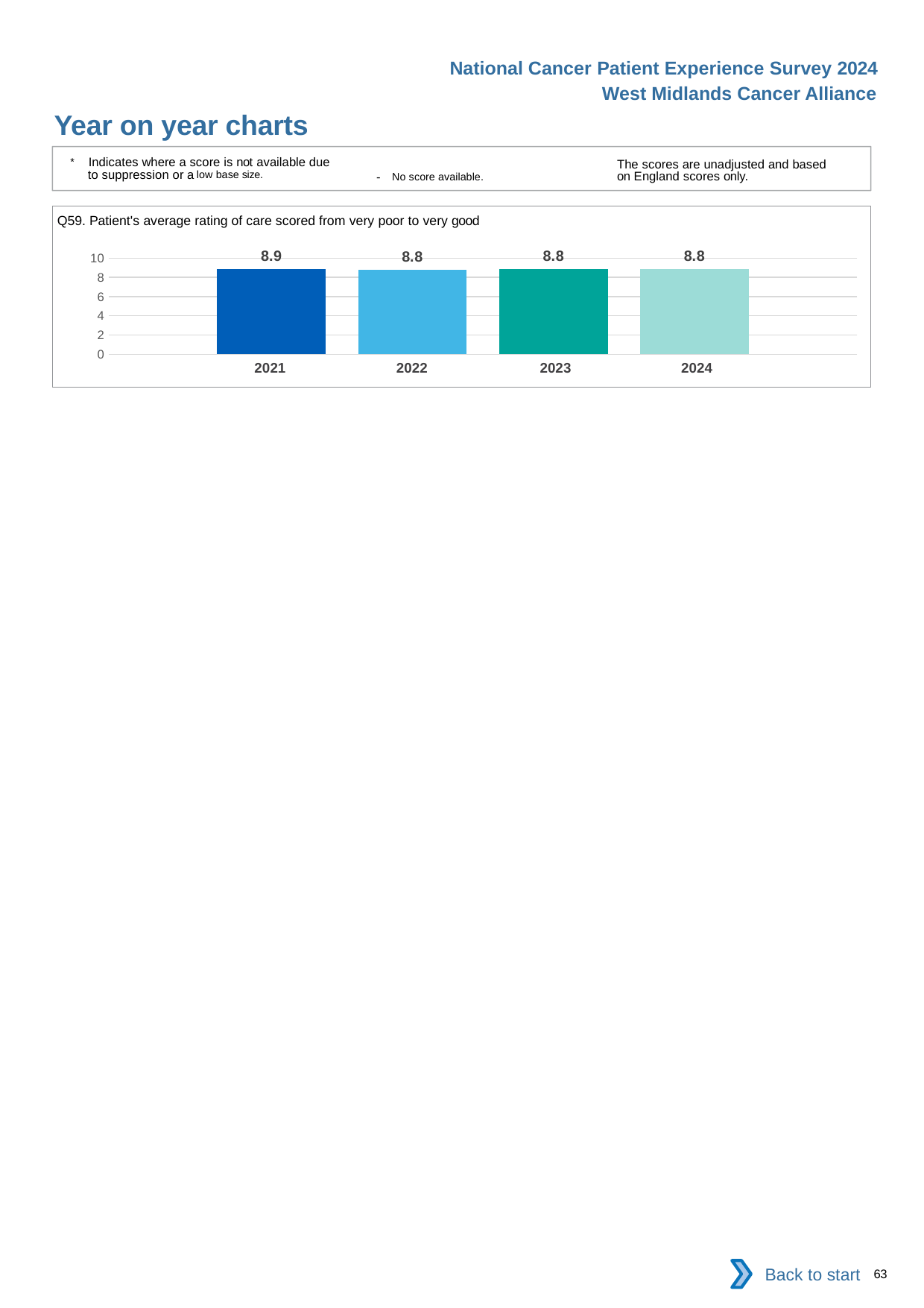
How many years are shown in the Q59 chart? 4 Do the values in the Q59 chart rise or fall from 2021 to 2022? Fall What is the value for 2022 in the Q59 chart? 8.8 What is the difference between the 2021 and 2023 values in the Q59 chart? 0.1 What is the title of the chart on the slide? Q59. Patient's average rating of care scored from very poor to very good Is the value for 2023 greater or less than 8 in the Q59 chart? greater Which year has the highest value in the Q59 chart? 2021 What is the maximum value shown on the y axis of the Q59 chart? 10 What is the value for 2024 in the Q59 chart? 8.8 Is the value for 2021 larger than the value for 2022 in the Q59 chart? Yes What kind of chart is shown for Q59? Bar chart What is the value for 2021 in the Q59 chart? 8.9